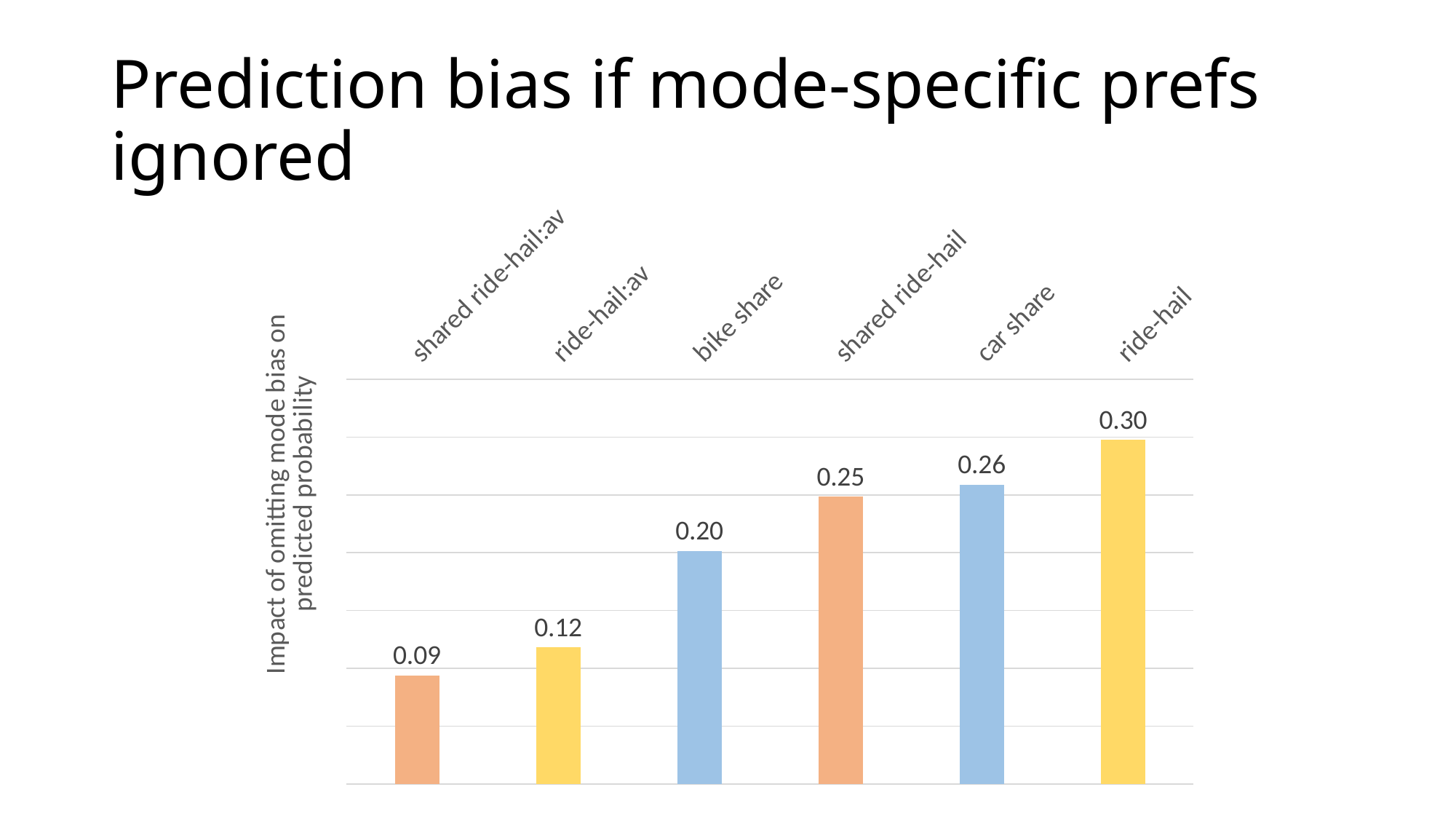
What is the value for shared ride-hail:av? 0.09 Do the values rise or fall from left to right across the categories? rise What is the difference between the values for bike share and ride-hail:av? 0.08 What kind of chart is shown on the slide? bar chart Which category has the lowest value? shared ride-hail:av How many categories are shown in the chart? 6 What is the difference between the values for ride-hail and shared ride-hail? 0.05 What is the value for car share? 0.26 Which is larger, the value for shared ride-hail or the value for bike share? shared ride-hail Which category has the highest value? ride-hail What is the value for bike share? 0.20 What is the value for ride-hail:av? 0.12